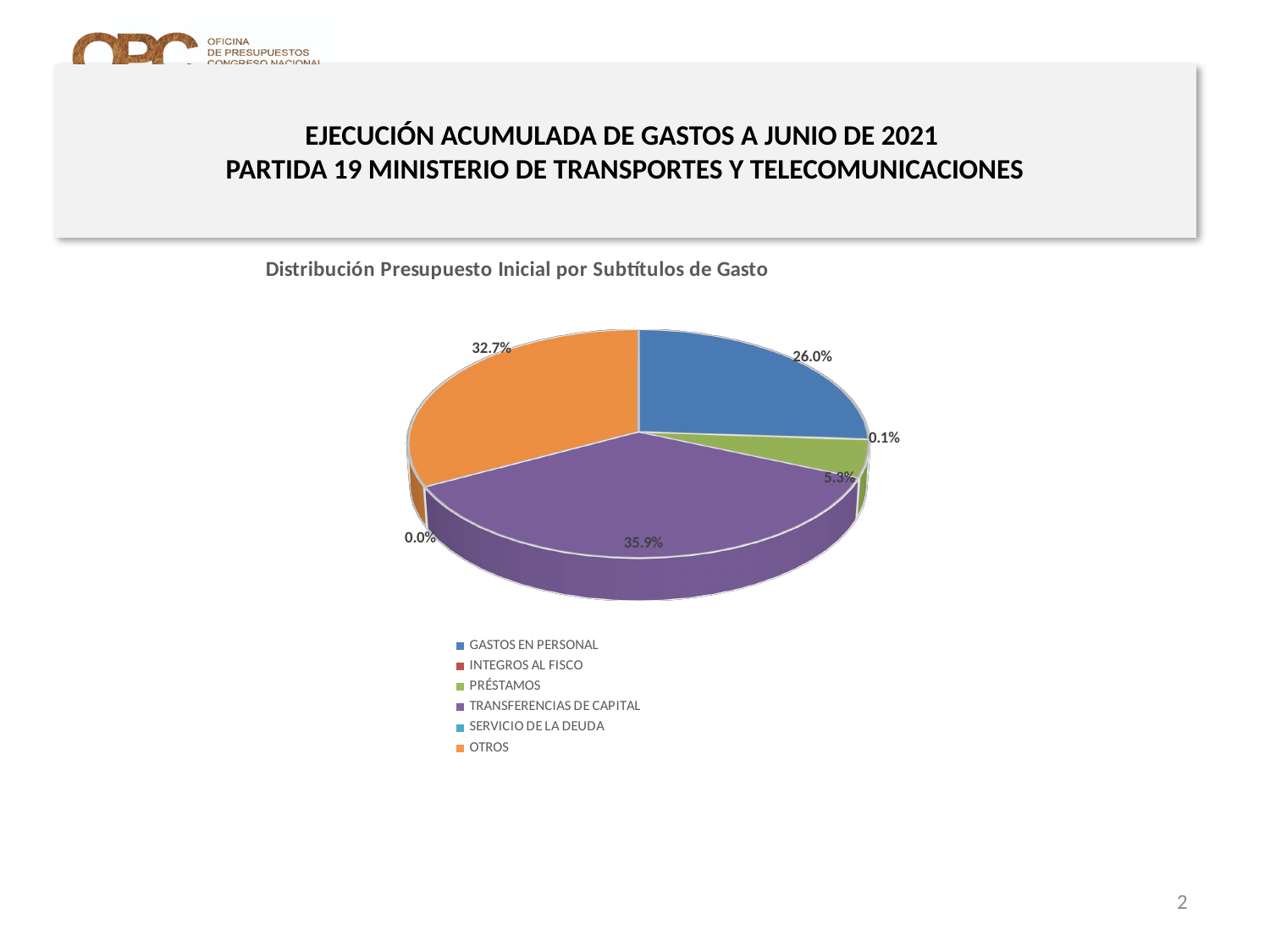
What is the title of the chart? Distribución Presupuesto Inicial por Subtítulos de Gasto Which category has the smallest share of the pie? SERVICIO DE LA DEUDA Which category has the largest share of the pie? TRANSFERENCIAS DE CAPITAL Which is larger, the share for GASTOS EN PERSONAL or the share for OTROS? OTROS What share of the pie does OTROS represent? 32.7% What share of the pie does PRÉSTAMOS represent? 5.3% How many categories does the legend list? 6 What is the difference in percentage points between TRANSFERENCIAS DE CAPITAL and OTROS? 3.2 What share of the pie does GASTOS EN PERSONAL represent? 26.0% What kind of chart is shown on the slide? Pie chart What share of the pie does TRANSFERENCIAS DE CAPITAL represent? 35.9% What colour is the slice for TRANSFERENCIAS DE CAPITAL? Purple